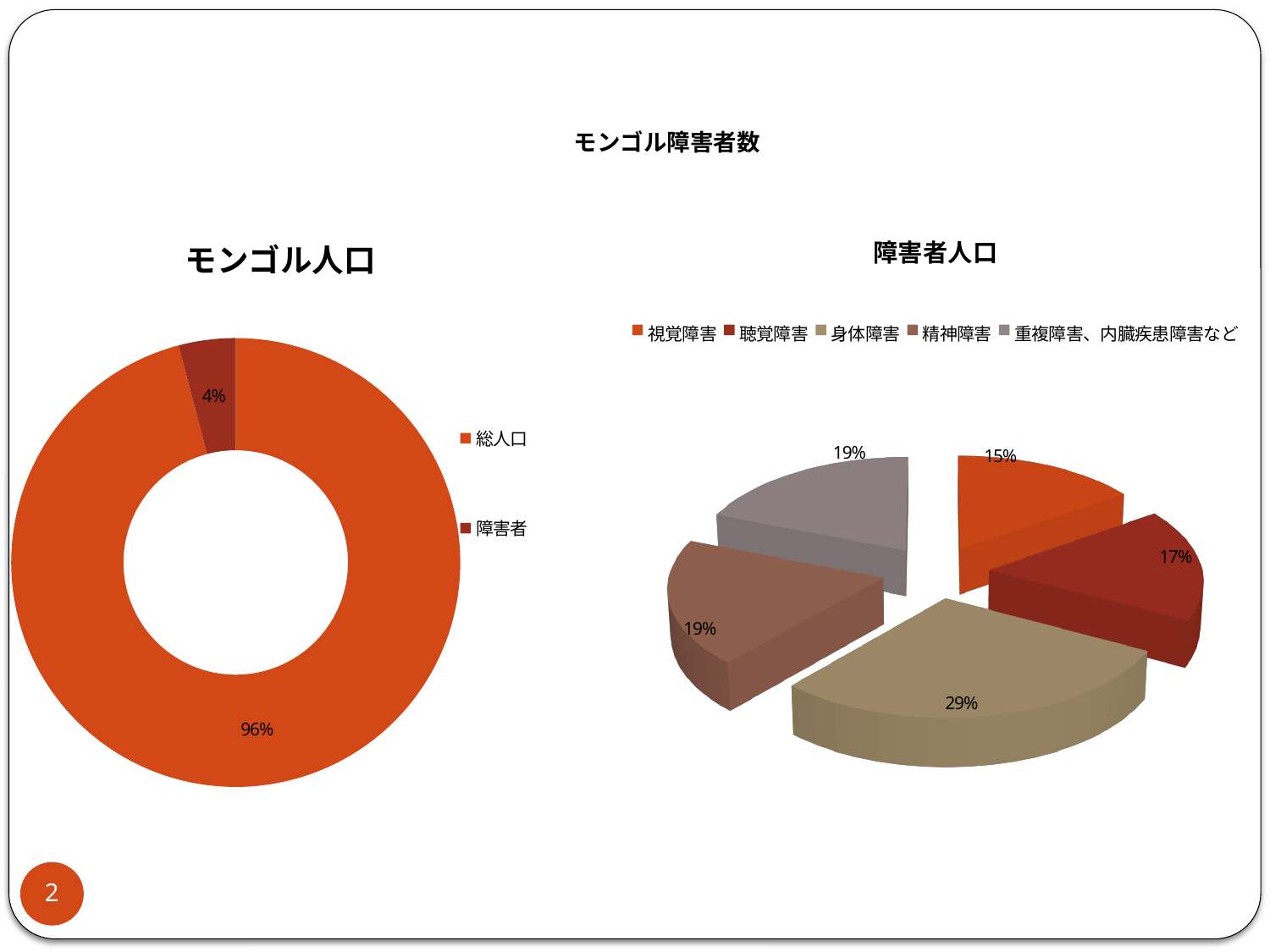
In the 障害者人口 chart, what percentage is shown for 視覚障害? 15% What kind of chart is the 障害者人口 chart? Pie chart In the 障害者人口 chart, what percentage is shown for 聴覚障害? 17% In the 障害者人口 chart, which category has the largest share? 身体障害 In the 障害者人口 chart, how many categories does the legend list? 5 What kind of chart is the モンゴル人口 chart? Doughnut chart In the 障害者人口 chart, which is larger, 聴覚障害 or 精神障害? 精神障害 In the モンゴル人口 chart, what is the difference between the 総人口 and 障害者 percentages? 92% In the 障害者人口 chart, which category has the smallest share? 視覚障害 In the モンゴル人口 chart, what percentage is shown for 総人口? 96% In the 障害者人口 chart, what percentage is shown for 身体障害? 29% In the モンゴル人口 chart, what percentage is shown for 障害者? 4%